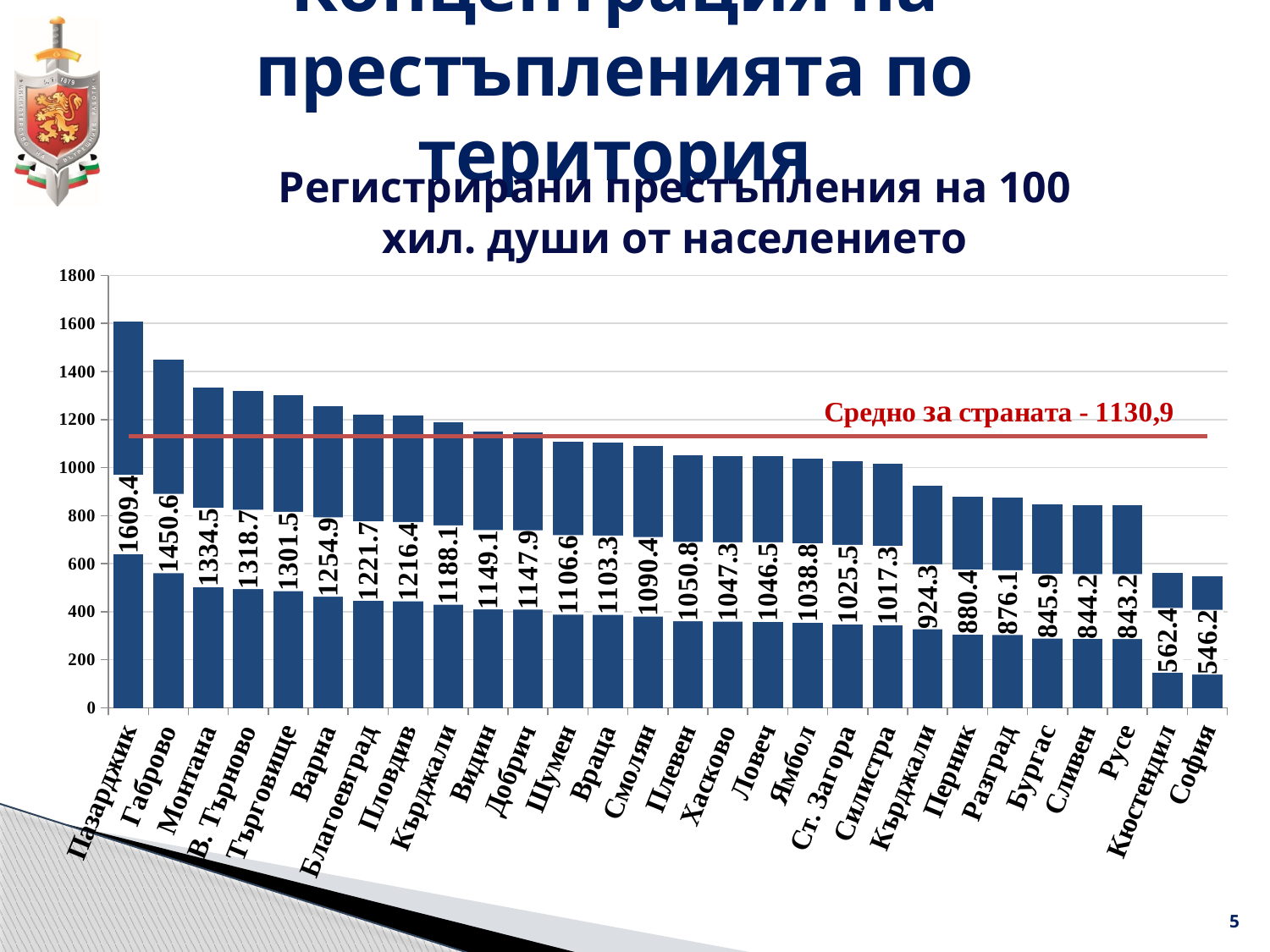
What is the value for Габрово? 1450.6 What is the national average value shown by the red line (Средно за страната)? 1130,9 What kind of chart is shown on the slide? bar chart Which category has the lowest value? София Is the value for Кюстендил greater or less than 600? less What is the value for София? 546.2 What is the value for Варна? 1254.9 Which category has the highest value? Пазарджик What is the value for Пазарджик? 1609.4 Which is larger, the value for Монтана or the value for Русе? Монтана How many bars are shown in the chart? 28 What is the difference between the values for Пазарджик and Габрово? 158.8